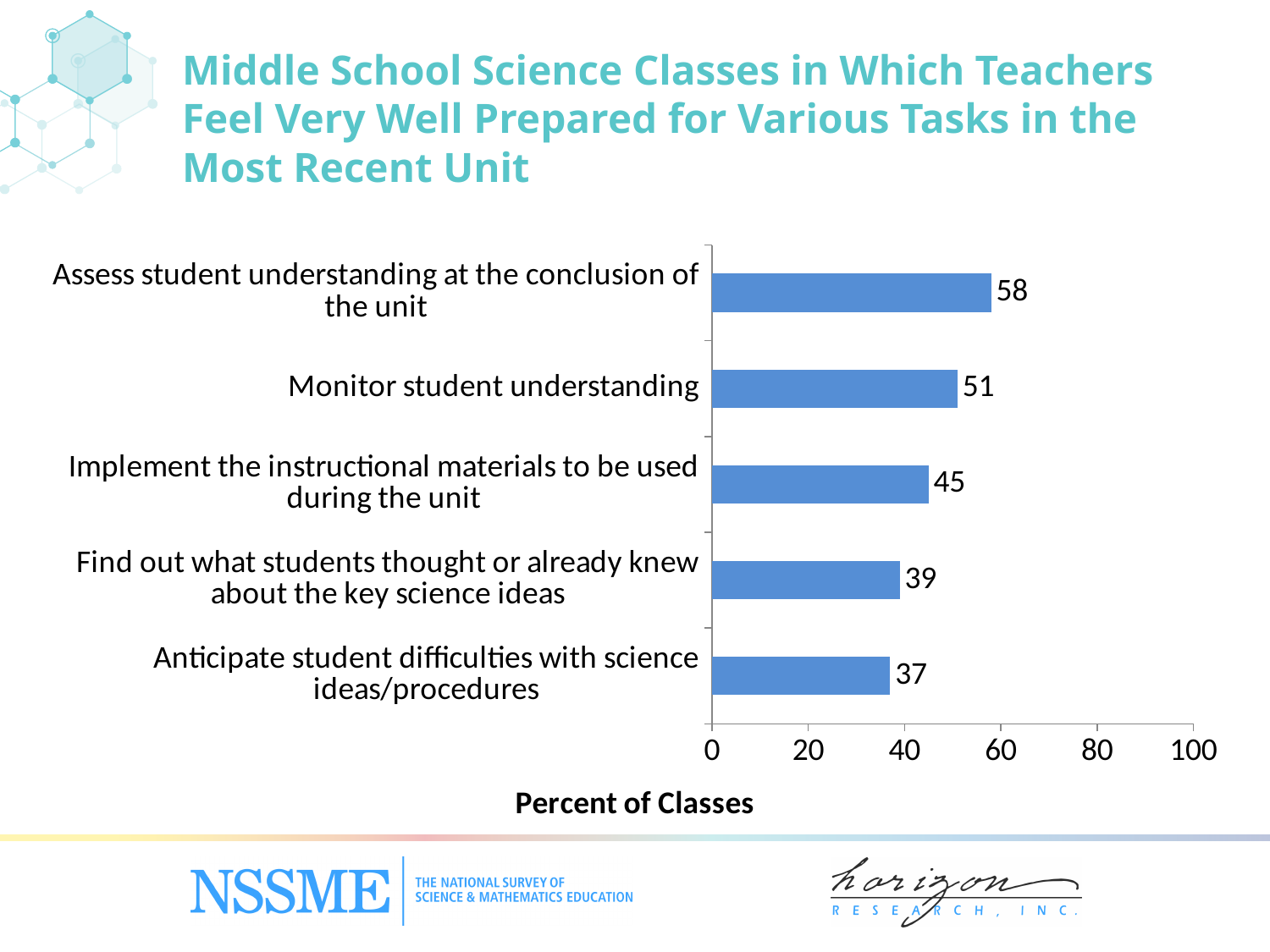
What is the value for "Implement the instructional materials to be used during the unit"? 45 What kind of chart is shown on the slide? Bar chart Which task has the highest percent of classes? Assess student understanding at the conclusion of the unit Which task has the lowest percent of classes? Anticipate student difficulties with science ideas/procedures What percent of classes is shown for "Monitor student understanding"? 51 How many tasks (categories) are shown in the chart? 5 Is the value for "Find out what students thought or already knew about the key science ideas" greater or less than 40? less What is the maximum value shown on the horizontal axis? 100 What is the value for "Anticipate student difficulties with science ideas/procedures"? 37 What is the difference between the values for "Assess student understanding at the conclusion of the unit" and "Monitor student understanding"? 7 Which is larger: the value for "Find out what students thought or already knew about the key science ideas" or for "Implement the instructional materials to be used during the unit"? Implement the instructional materials to be used during the unit What is the label of the horizontal axis? Percent of Classes